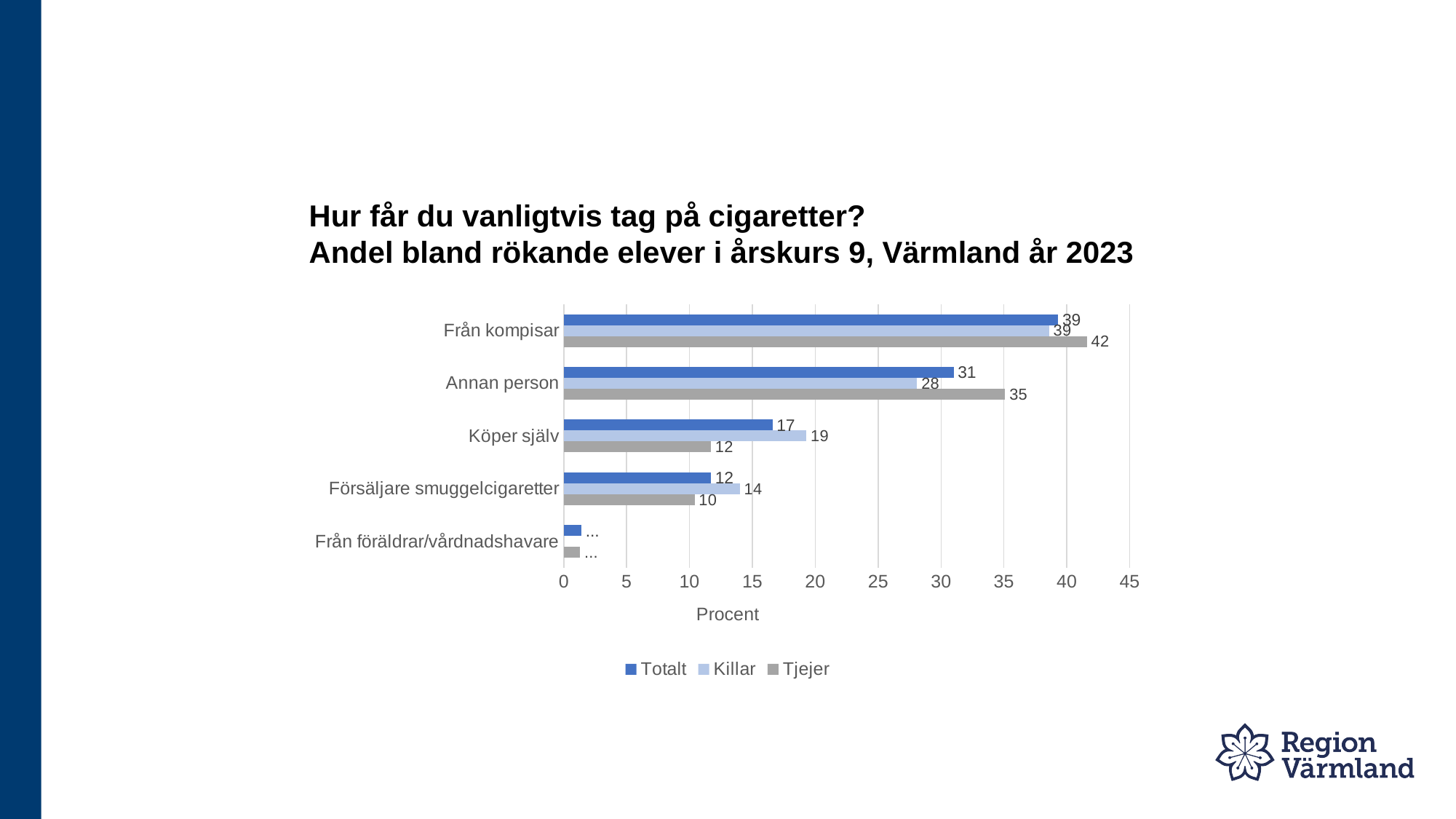
Is the Totalt value for Annan person greater or less than 30? greater What is the difference between the Tjejer and Killar values for Annan person? 7 What is the Tjejer value for Försäljare smuggelcigaretter? 10 What is the Totalt value for Från kompisar? 39 Which category has the highest Tjejer value? Från kompisar How many series does the legend list? 3 What is the Killar value for Köper själv? 19 Among the categories with printed values, which has the lowest Killar value? Försäljare smuggelcigaretter What kind of chart is shown on the slide? Bar chart For Köper själv, which is larger: the Killar value or the Tjejer value? Killar How many categories are shown on the y axis? 5 What is the Tjejer value for Annan person? 35